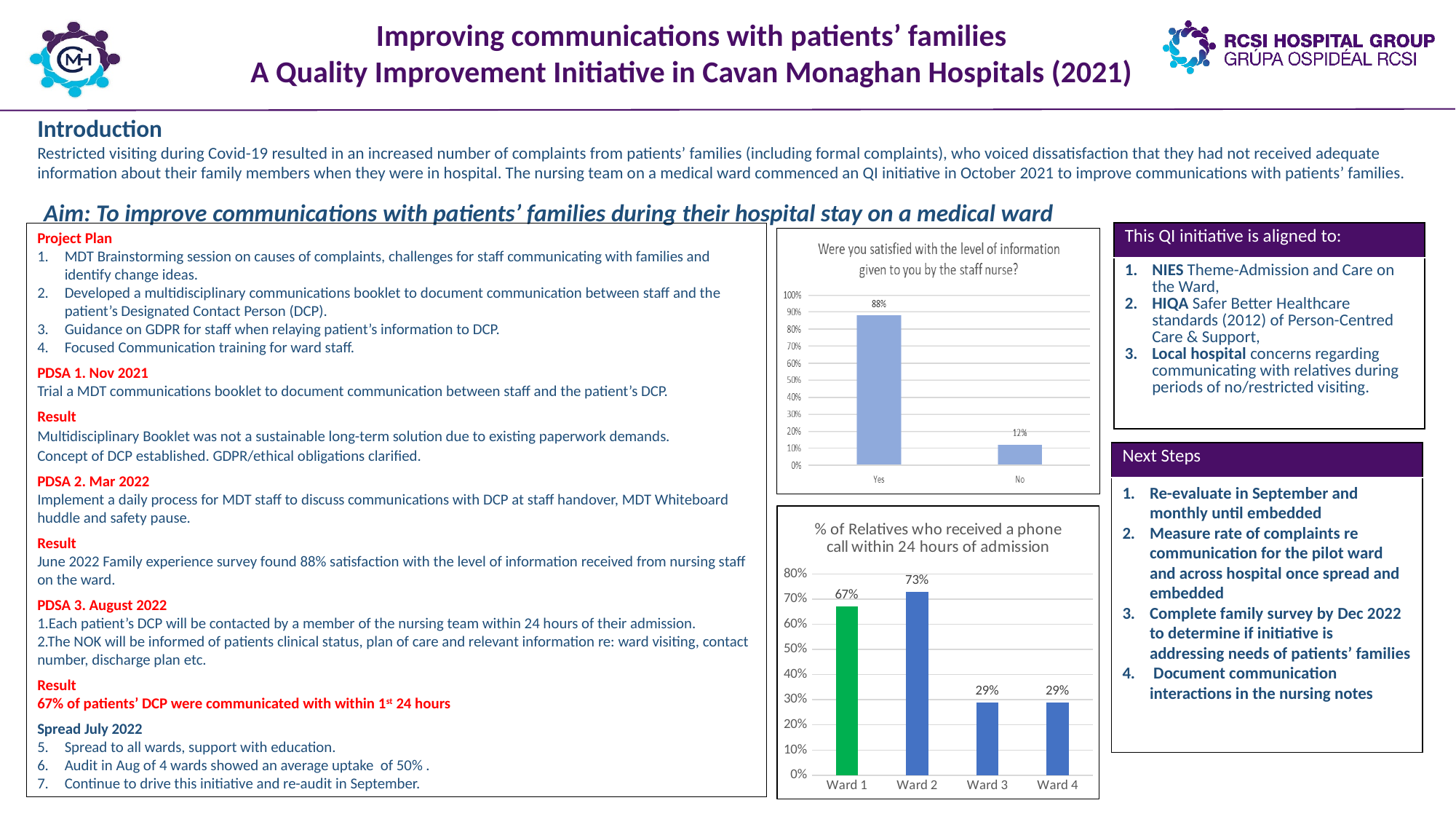
In the chart titled 'Were you satisfied with the level of information given to you by the staff nurse?', what is the value for 'Yes'? 88% In the chart titled '% of Relatives who received a phone call within 24 hours of admission', which ward has the highest value? Ward 2 In the chart titled '% of Relatives who received a phone call within 24 hours of admission', what is the value for Ward 2? 73% In the chart titled '% of Relatives who received a phone call within 24 hours of admission', which ward's bar is coloured green? Ward 1 In the chart titled '% of Relatives who received a phone call within 24 hours of admission', how many wards are shown? 4 In the chart titled 'Were you satisfied with the level of information given to you by the staff nurse?', what is the value for 'No'? 12% In the chart titled 'Were you satisfied with the level of information given to you by the staff nurse?', how many categories are shown on the x axis? 2 In the chart titled '% of Relatives who received a phone call within 24 hours of admission', what is the difference between Ward 2 and Ward 3? 44% In the chart titled '% of Relatives who received a phone call within 24 hours of admission', which is larger, Ward 1 or Ward 4? Ward 1 In the chart titled '% of Relatives who received a phone call within 24 hours of admission', what is the value for Ward 1? 67% What kind of chart is the one titled '% of Relatives who received a phone call within 24 hours of admission'? Bar chart In the chart titled 'Were you satisfied with the level of information given to you by the staff nurse?', what is the difference between the 'Yes' and 'No' values? 76%